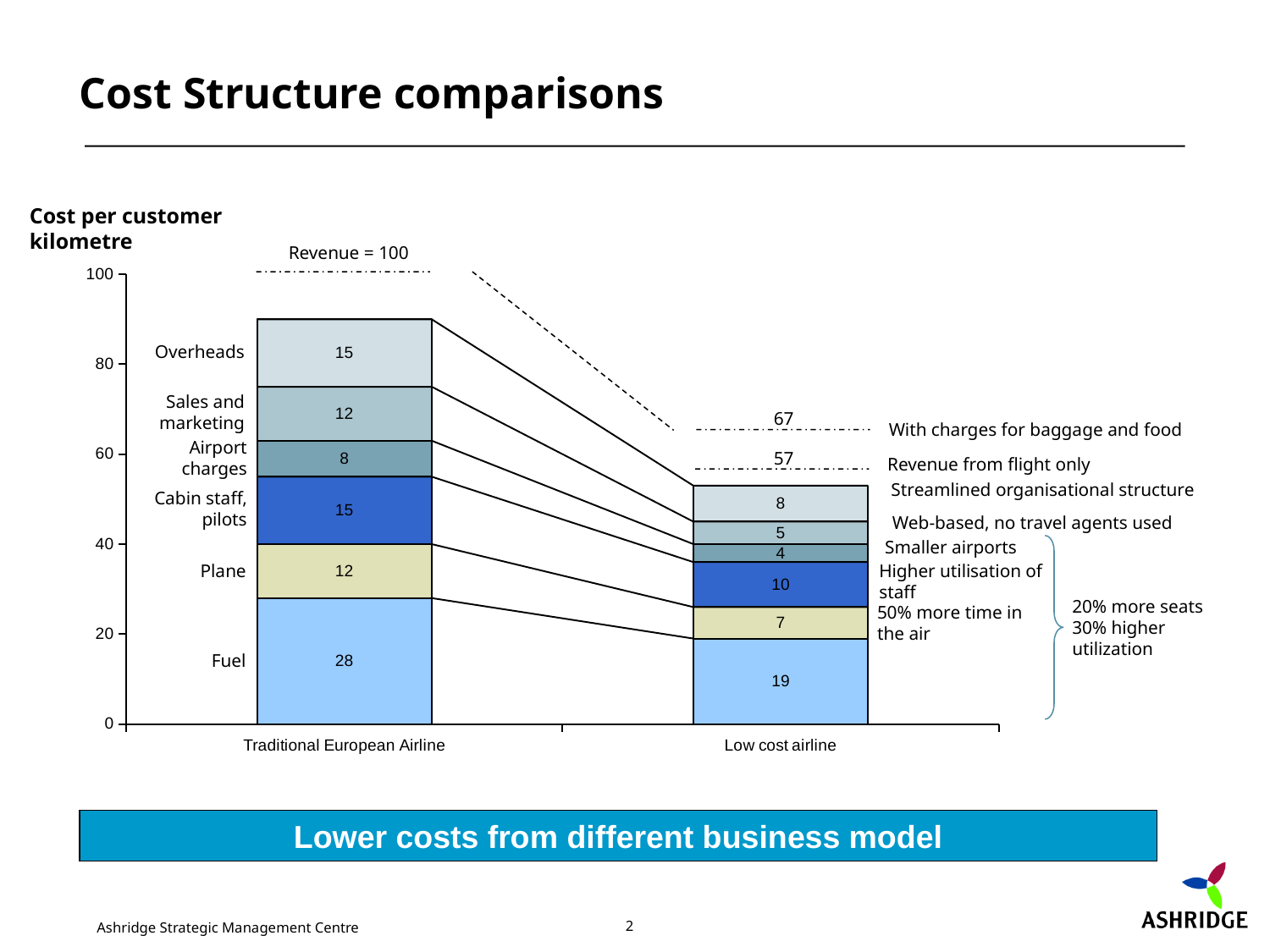
What is the Fuel cost for the Low cost airline? 19 What is the Airport charges value for the Low cost airline? 4 What is the Cabin staff, pilots value for the Traditional European Airline? 15 Which cost segment is the largest for the Low cost airline? Fuel What is the difference in Fuel cost between the Traditional European Airline and the Low cost airline? 9 What is the total cost per customer kilometre for the Low cost airline bar? 53 Which cost segment is the smallest for the Traditional European Airline? Airport charges What is the Overheads value for the Low cost airline? 8 What is the total cost per customer kilometre for the Traditional European Airline bar? 90 Is the Plane cost larger for the Traditional European Airline or the Low cost airline? Traditional European Airline What is the Fuel cost for the Traditional European Airline? 28 What kind of chart is shown on the slide? Stacked bar chart